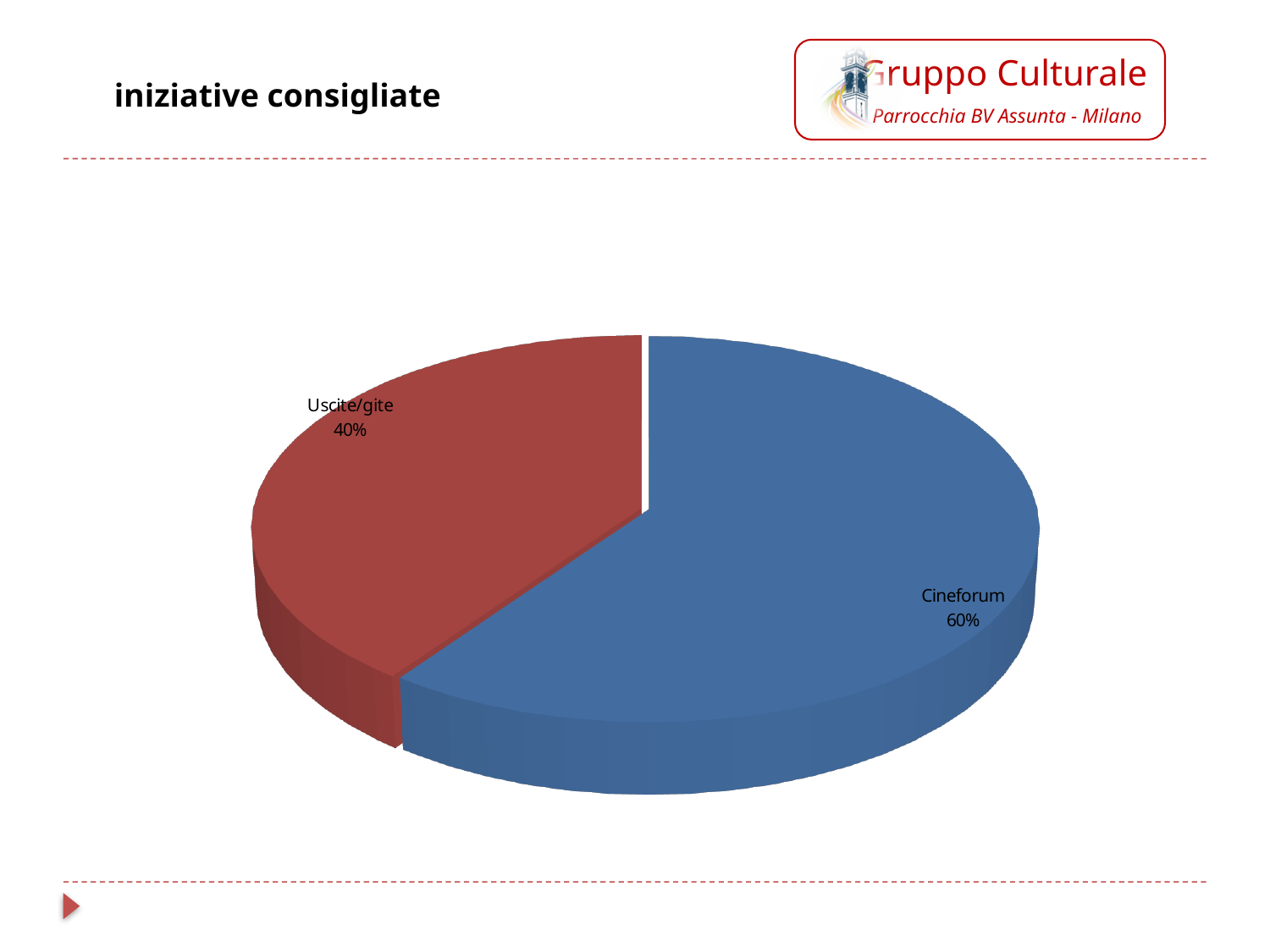
What is the title of the slide containing the chart? iniziative consigliate Which slice is the smallest? Uscite/gite What share of the pie does Uscite/gite have? 40% What is the difference in percentage points between Cineforum and Uscite/gite? 20 percentage points What colour is the Cineforum slice? blue Which is larger, Cineforum or Uscite/gite? Cineforum What kind of chart is shown on the slide? pie chart How many slices does the pie chart have? 2 Which slice is the largest? Cineforum What share of the pie does Cineforum have? 60%